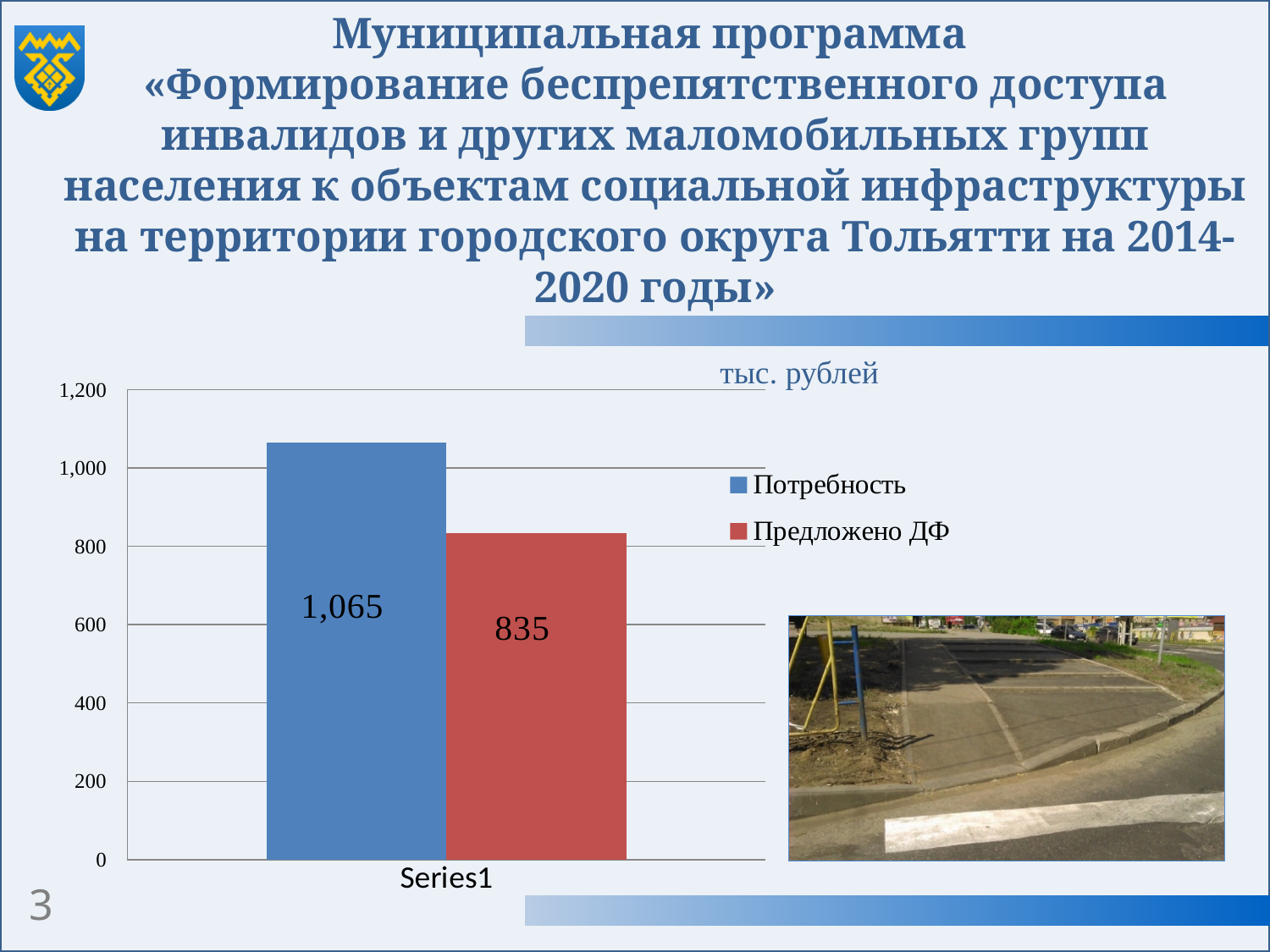
How many series does the legend list? 2 What kind of chart is shown on the slide? bar chart Is the value for Потребность greater or less than 1,000? greater What is the value for Предложено ДФ? 835 What is the value for Потребность? 1,065 What unit is indicated above the chart? тыс. рублей Is the value for Предложено ДФ greater or less than 800? greater What is the difference between Потребность and Предложено ДФ? 230 Which series has the higher value, Потребность or Предложено ДФ? Потребность What colour is the bar for Предложено ДФ? red What is the highest value shown on the vertical axis? 1,200 Which series has the lowest value? Предложено ДФ